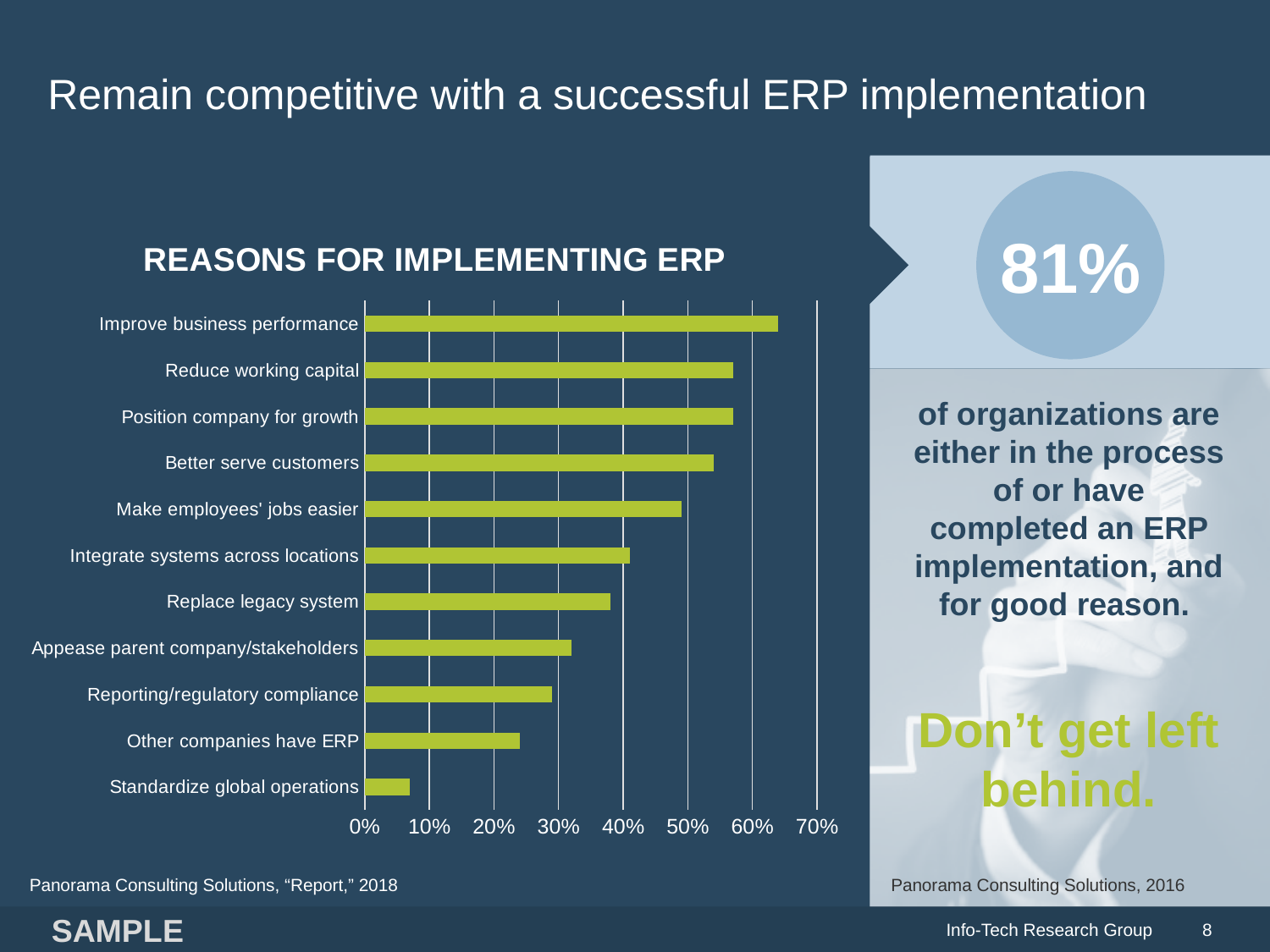
Which reason for implementing ERP has the highest value in the chart? Improve business performance What is the title of the bar chart on the slide? REASONS FOR IMPLEMENTING ERP Which has a larger value: "Improve business performance" or "Other companies have ERP"? Improve business performance Is the value for "Replace legacy system" greater or less than 30%? greater How many reasons (categories) are listed in the "REASONS FOR IMPLEMENTING ERP" chart? 11 Is the value for "Better serve customers" greater or less than 50%? greater Which has a larger value: "Integrate systems across locations" or "Standardize global operations"? Integrate systems across locations Is the value for "Improve business performance" greater or less than 60%? greater What type of chart is shown under the title "REASONS FOR IMPLEMENTING ERP"? Bar chart Which reason for implementing ERP has the lowest value in the chart? Standardize global operations